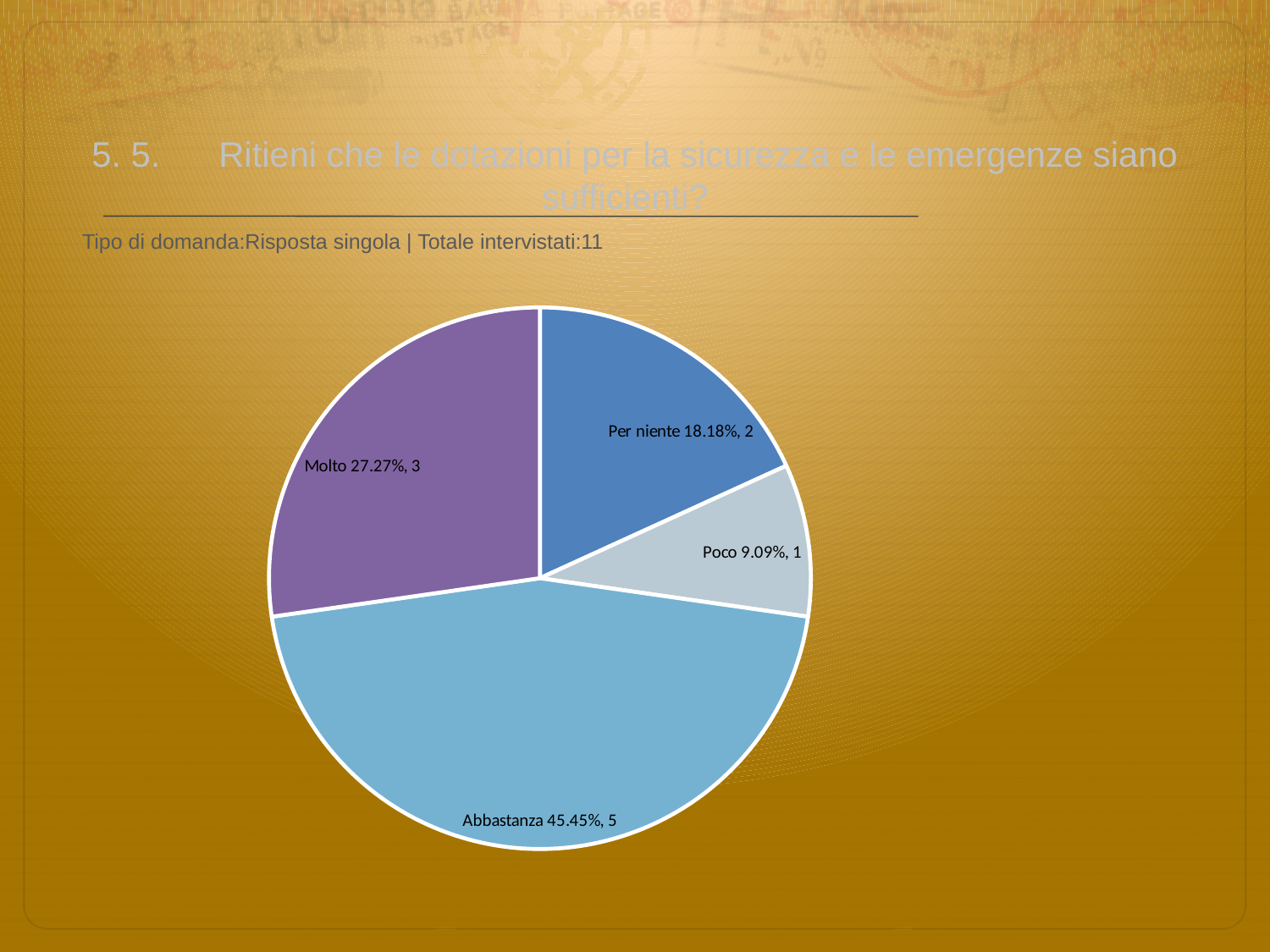
Which category has the largest slice of the pie? Abbastanza How many respondents answered Molto? 3 What is the difference in respondent count between Abbastanza and Molto? 2 What is the total number of respondents across all slices? 11 Which category has the smallest slice of the pie? Poco What kind of chart is shown on the slide? pie chart How many slices does the pie chart have? 4 Which has more respondents, Per niente or Poco? Per niente How many respondents answered Per niente? 2 What percentage share does the Poco slice have? 9.09% What percentage share does the Abbastanza slice have? 45.45% What colour is the Molto slice? purple